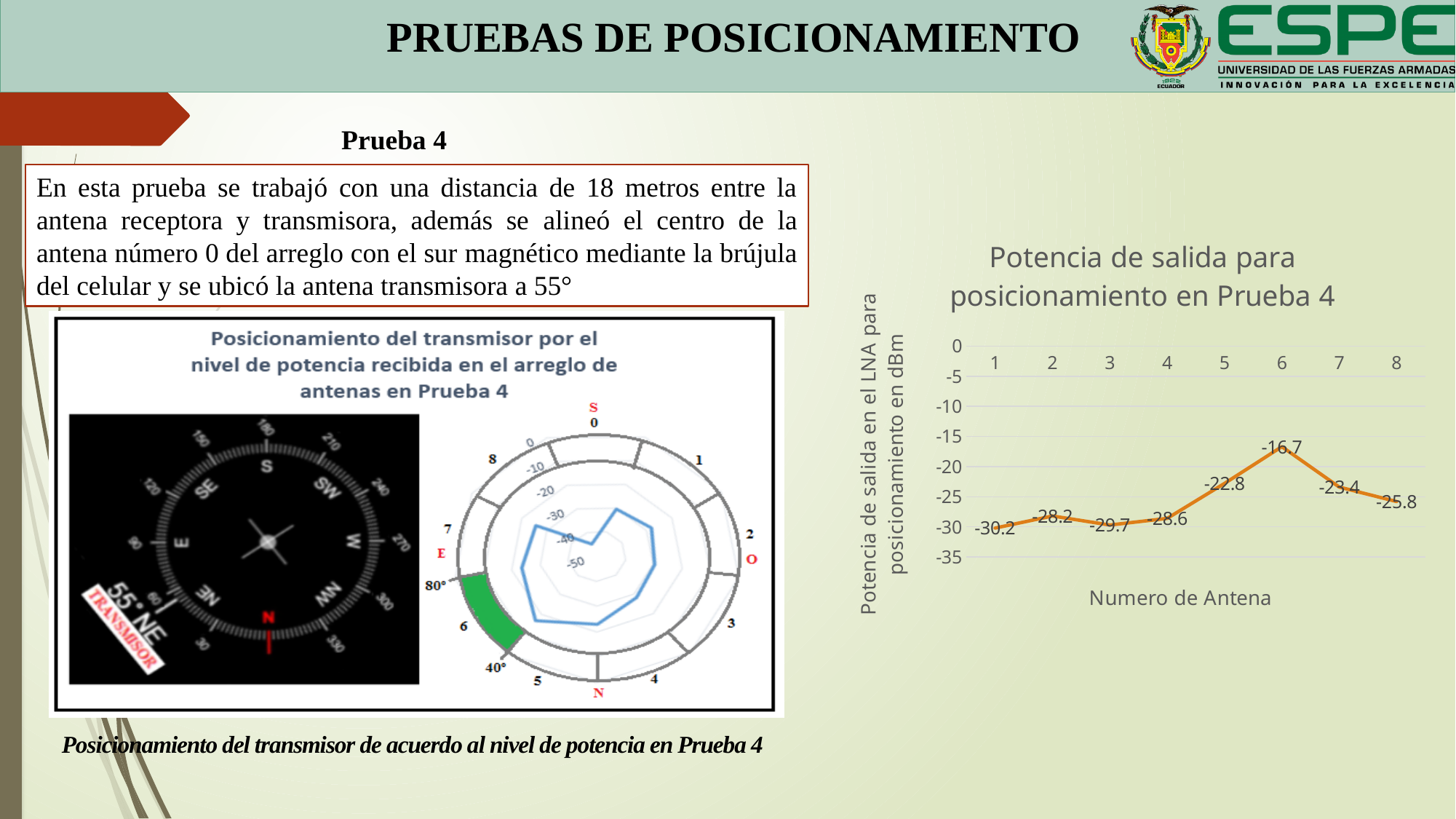
In the chart 'Potencia de salida para posicionamiento en Prueba 4', which antenna number has the lowest output power? 1 In the chart 'Potencia de salida para posicionamiento en Prueba 4', what is the value for antenna 1? -30.2 What is the x-axis title of the chart 'Potencia de salida para posicionamiento en Prueba 4'? Numero de Antena In the chart 'Potencia de salida para posicionamiento en Prueba 4', what is the difference between the values for antenna 6 and antenna 7? 6.7 In the chart 'Potencia de salida para posicionamiento en Prueba 4', what is the value for antenna 8? -25.8 What kind of chart is 'Potencia de salida para posicionamiento en Prueba 4'? Line chart In the chart 'Potencia de salida para posicionamiento en Prueba 4', which antenna number has the highest output power? 6 In the chart 'Potencia de salida para posicionamiento en Prueba 4', is the value for antenna 3 greater or less than -25? less How many antenna numbers are plotted in the chart 'Potencia de salida para posicionamiento en Prueba 4'? 8 In the chart 'Potencia de salida para posicionamiento en Prueba 4', what is the value for antenna 6? -16.7 In the chart 'Potencia de salida para posicionamiento en Prueba 4', does the value rise or fall from antenna 6 to antenna 8? Fall In the chart 'Potencia de salida para posicionamiento en Prueba 4', which has the larger value, antenna 5 or antenna 7? Antenna 5